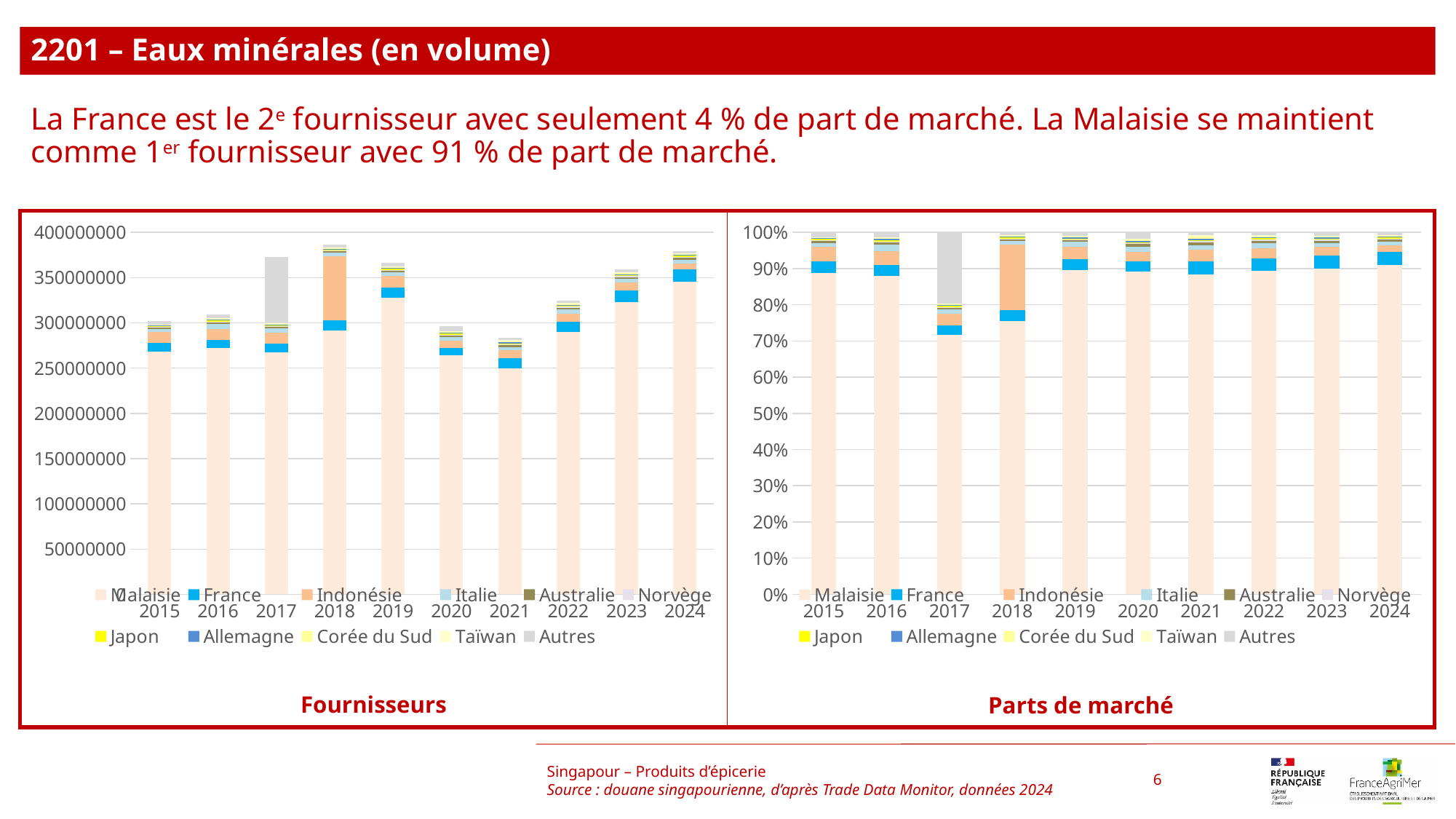
In the 'Parts de marché' chart, is the Malaisie share in 2024 greater or less than 90%? greater In the 'Fournisseurs' chart, is the total bar for 2018 greater or less than 350000000? greater In the 'Fournisseurs' chart, do the total bars rise or fall from 2021 to 2024? rise In the 'Fournisseurs' chart, which total bar is taller, 2019 or 2022? 2019 In the 'Parts de marché' chart, which year has the largest 'Autres' share? 2017 How many years are shown on the x axis of the 'Parts de marché' chart? 10 What colour represents France in the legend of the charts? blue How many series does the legend of the 'Fournisseurs' chart list? 11 In the 'Fournisseurs' chart, which year has the lowest total bar? 2021 In the 'Parts de marché' chart, is the Malaisie share in 2017 greater or less than 80%? less What kind of chart is the 'Fournisseurs' chart on the left? stacked bar chart